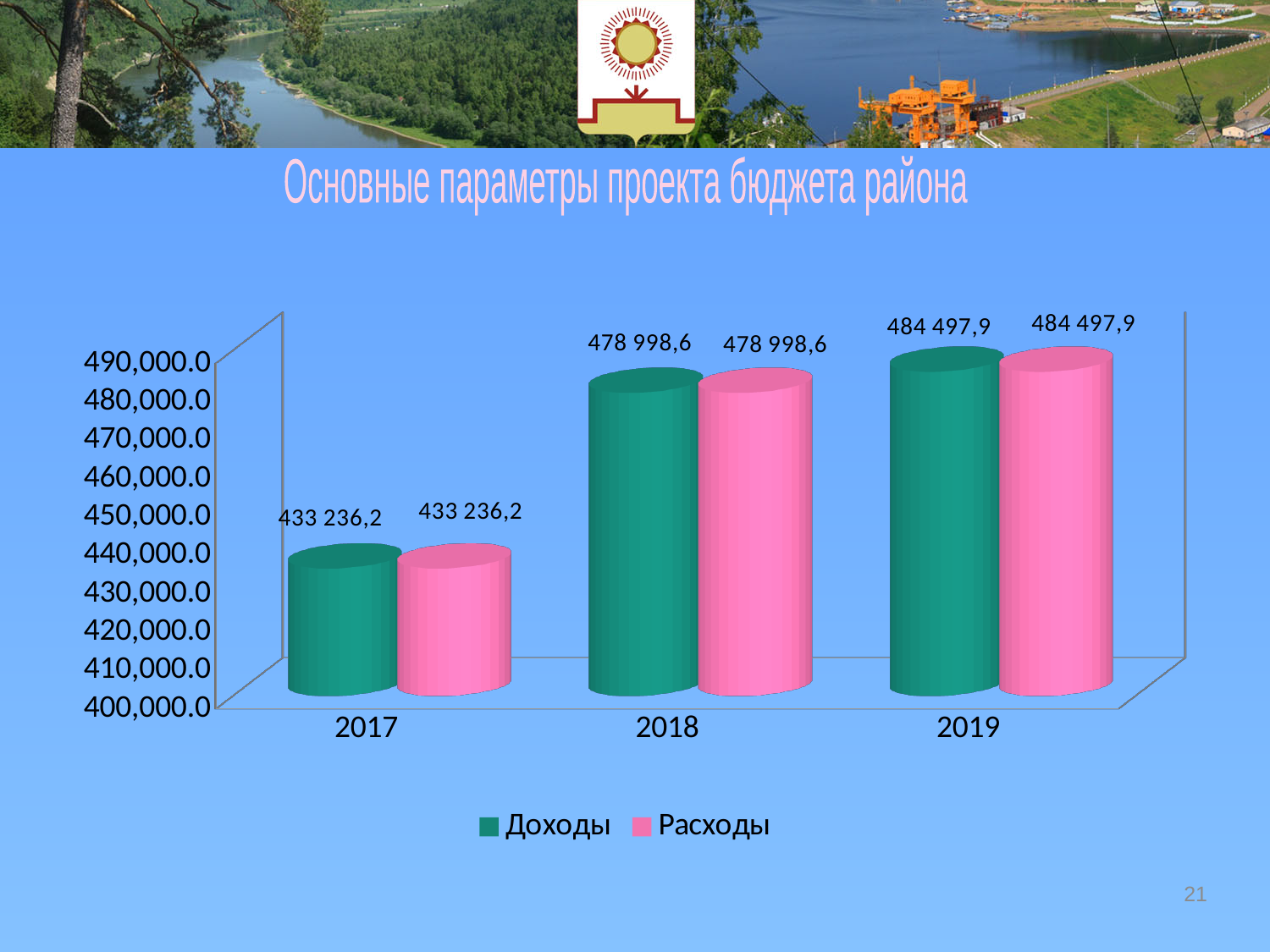
What kind of chart is shown on the slide? bar chart How many years are shown on the x axis? 3 What is the value of Доходы for 2019? 484 497,9 Which is larger: Расходы in 2019 or Расходы in 2018? Расходы in 2019 What is the value of Доходы for 2017? 433 236,2 What is the difference between Доходы in 2018 and Доходы in 2017? 45 762,4 Is the value for Доходы in 2017 greater or less than 440,000.0? less Which year has the highest value for Доходы? 2019 Do the values for Доходы rise or fall from 2017 to 2019? rise Which year has the lowest value for Расходы? 2017 What is the value of Расходы for 2018? 478 998,6 How many series does the legend list? 2